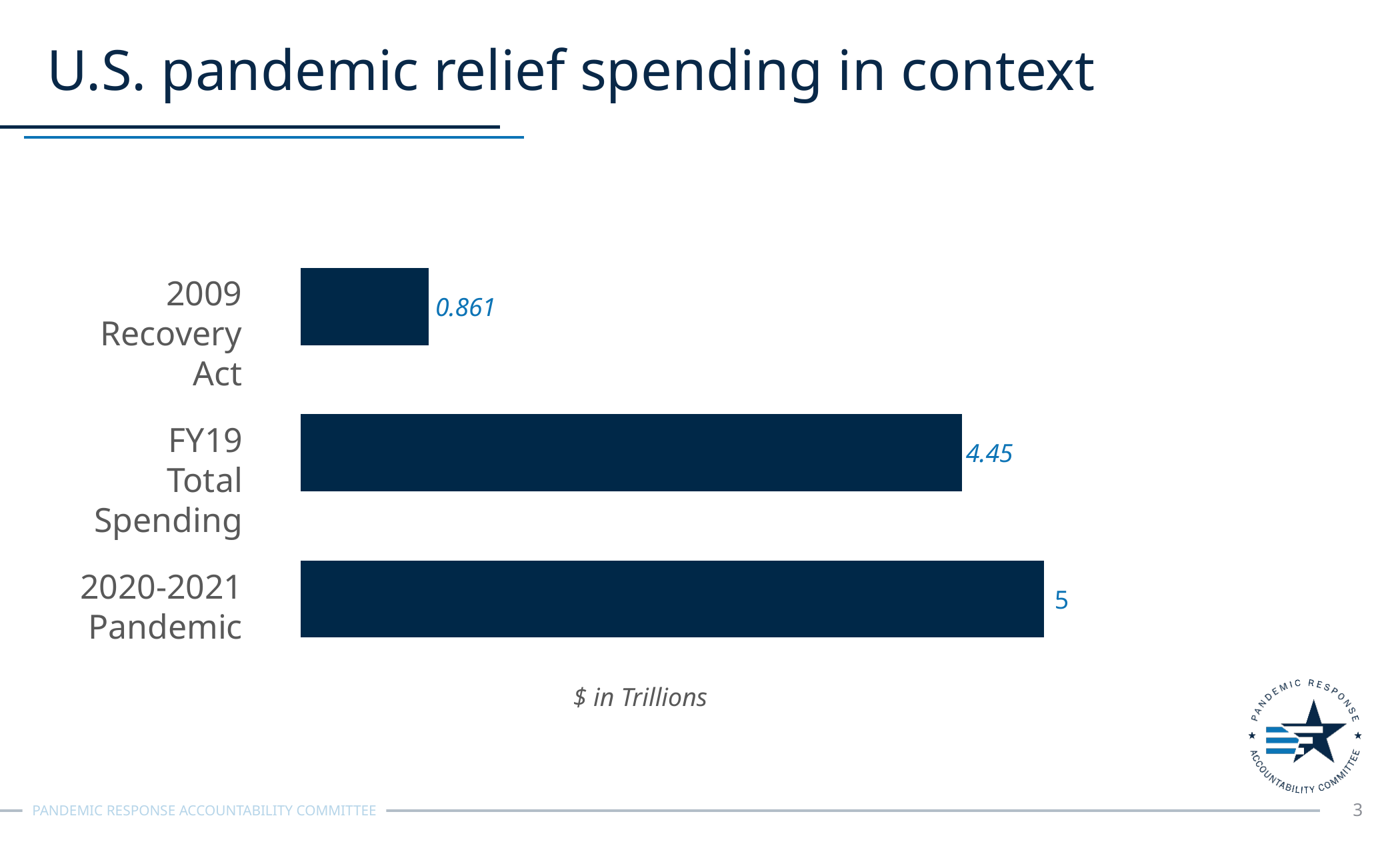
How many categories are shown in the chart? 3 Which is larger, the value for FY19 Total Spending or the value for the 2009 Recovery Act? FY19 Total Spending Which category has the lowest value? 2009 Recovery Act What kind of chart is shown on the slide? Bar chart What is the difference between the 2020-2021 Pandemic value and the FY19 Total Spending value? 0.55 What is the value for FY19 Total Spending? 4.45 What is the title of the slide? U.S. pandemic relief spending in context What is the value for the 2020-2021 Pandemic? 5 What unit is indicated below the chart? $ in Trillions What is the difference between the FY19 Total Spending value and the 2009 Recovery Act value? 3.589 What is the value for the 2009 Recovery Act? 0.861 Which category has the highest value? 2020-2021 Pandemic